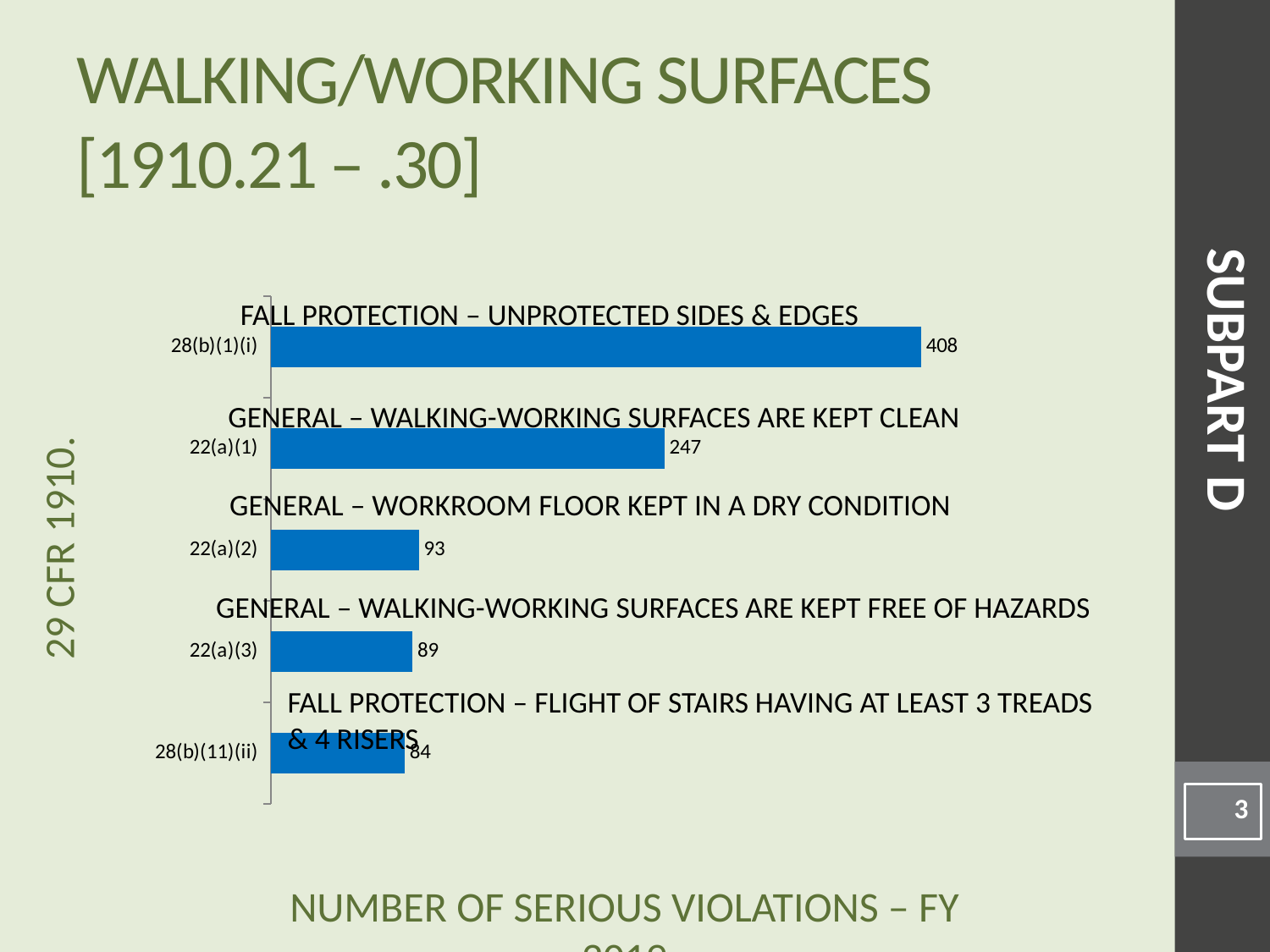
What is the difference between the values for 28(b)(1)(i) and 22(a)(1)? 161 What is the number of serious violations for 22(a)(1)? 247 Which category has the lowest number of serious violations? 28(b)(11)(ii) Which category is labelled 'GENERAL – WORKROOM FLOOR KEPT IN A DRY CONDITION'? 22(a)(2) Which category has the highest number of serious violations? 28(b)(1)(i) What is the number of serious violations for 28(b)(11)(ii)? 84 How many categories are shown in the chart? 5 What is the number of serious violations for 28(b)(1)(i)? 408 What kind of chart is shown on the slide? Bar chart Which has more serious violations, 22(a)(1) or 22(a)(2)? 22(a)(1) What is the number of serious violations for 22(a)(2)? 93 What is the difference between the values for 22(a)(2) and 22(a)(3)? 4